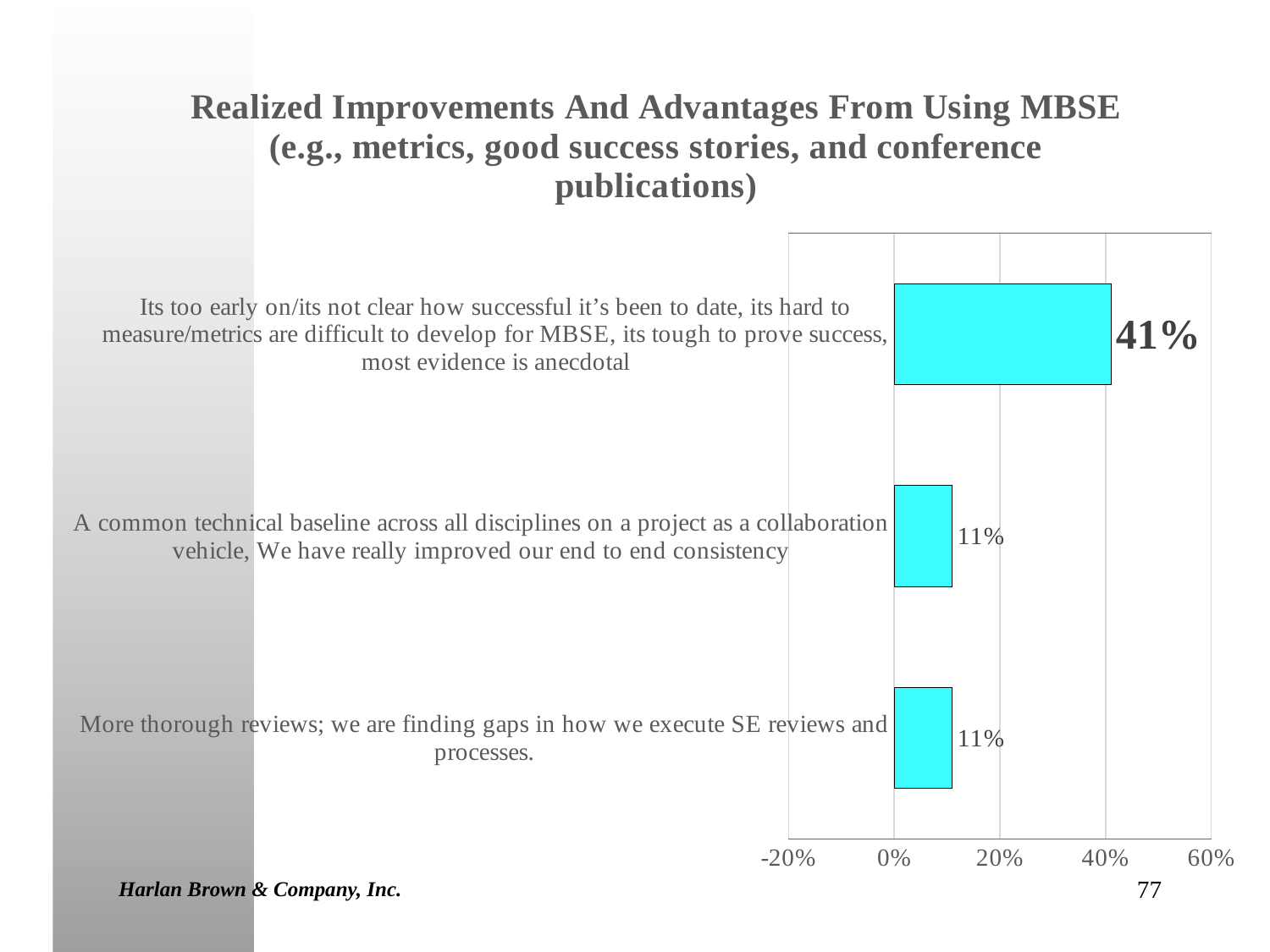
What kind of chart is shown on the slide? Bar chart What is the value for the category beginning "Its too early on/its not clear how successful it's been to date"? 41% What is the value for the category "A common technical baseline across all disciplines on a project as a collaboration vehicle, We have really improved our end to end consistency"? 11% What is the lowest value shown on the x axis? -20% Is the value for "A common technical baseline" greater or less than 20%? less Which category has the highest value? Its too early on/its not clear how successful it's been to date, its hard to measure/metrics are difficult to develop for MBSE, its tough to prove success, most evidence is anecdotal What is the difference between the highest value (41%) and the value for "More thorough reviews"? 30% Is the value for the "Its too early on" category greater or less than 20%? greater How many categories are shown in the chart? 3 Which is larger: the value for "Its too early on" or the value for "More thorough reviews"? Its too early on What is the value for the category "More thorough reviews; we are finding gaps in how we execute SE reviews and processes."? 11% What is the title of the chart? Realized Improvements And Advantages From Using MBSE (e.g., metrics, good success stories, and conference publications)